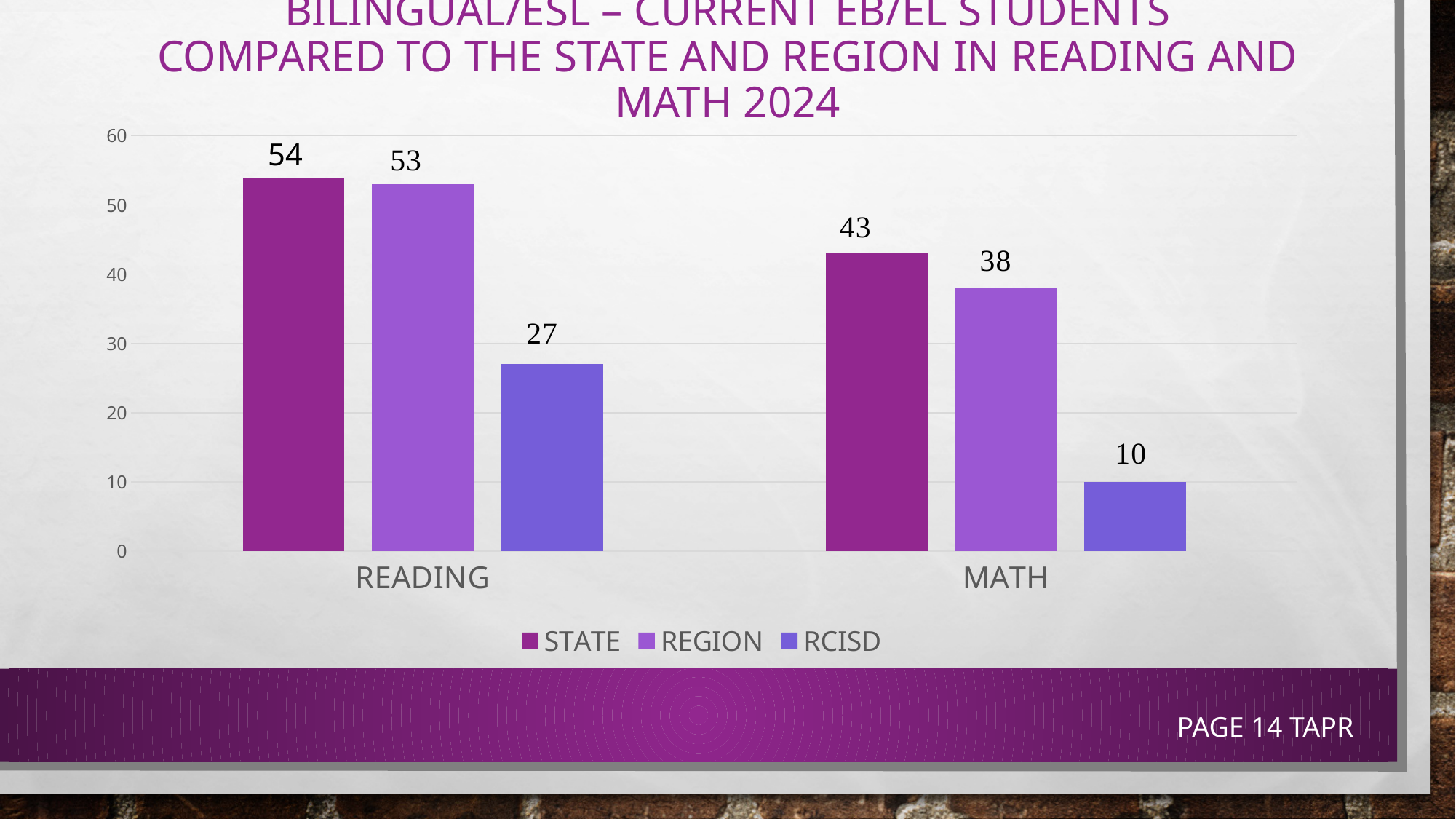
Which series has the lowest value for READING? RCISD What is the RCISD value for MATH? 10 How many series does the legend list? 3 What is the difference between the REGION and RCISD values for MATH? 28 Do the STATE values rise or fall from READING to MATH? Fall What is the REGION value for MATH? 38 What is the difference between the STATE and RCISD values for READING? 27 What is the STATE value for READING? 54 How many categories are shown on the x axis? 2 What kind of chart is shown on the slide? Bar chart Which series has the highest value for MATH? STATE Which is larger, the RCISD value for READING or the RCISD value for MATH? READING